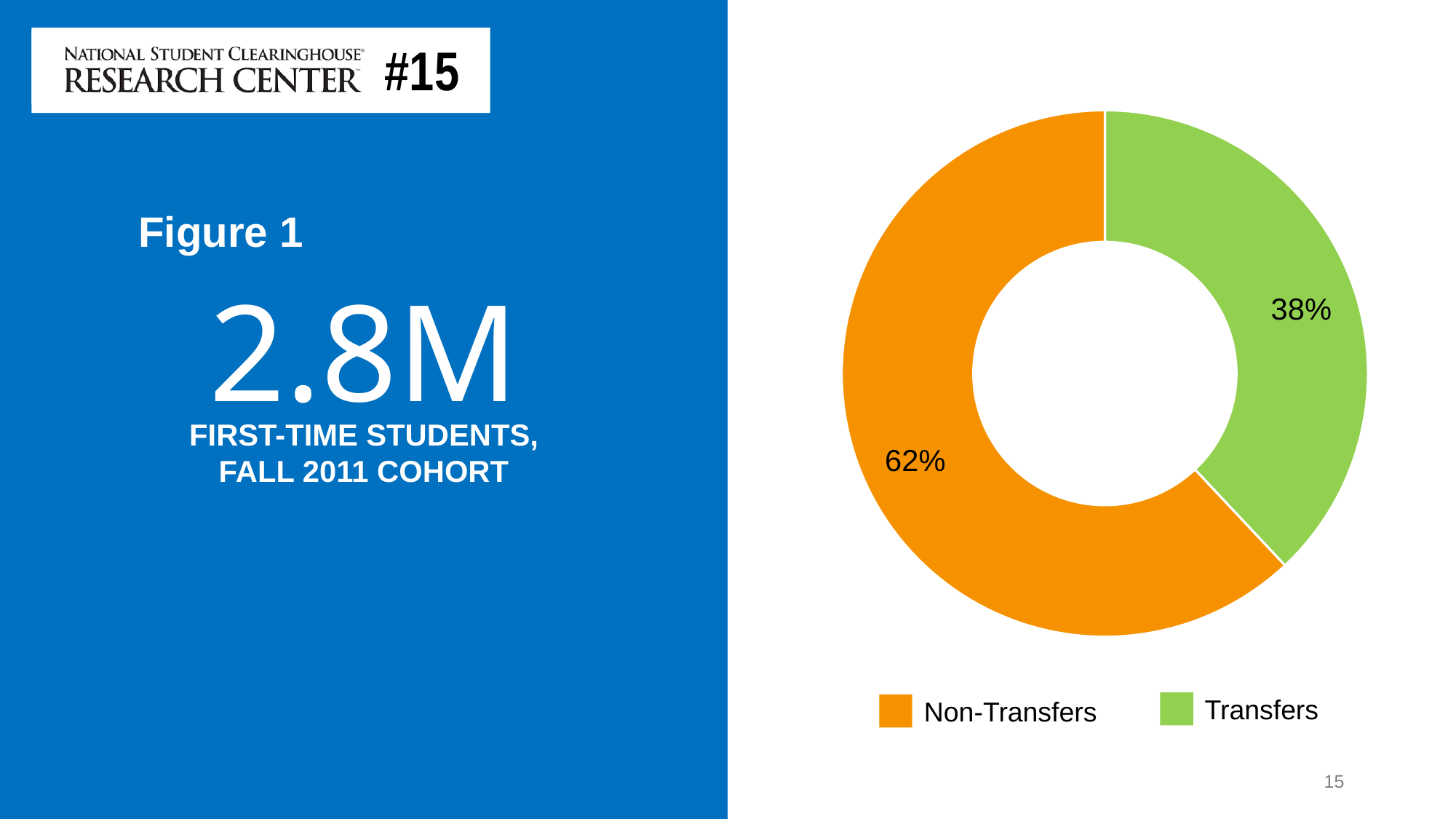
What kind of chart is shown on the slide? Donut (pie) chart Which category has the smallest share in the chart? Transfers Which is larger, the share for Non-Transfers or the share for Transfers? Non-Transfers What share of the donut chart is Transfers? 38% Which category has the largest share in the chart? Non-Transfers What colour represents Transfers in the chart? Green What is the total of the two shares shown in the chart? 100% How many entries does the legend list? 2 What is the difference in percentage points between Non-Transfers and Transfers? 24 percentage points How many categories does the chart show? 2 What share of the donut chart is Non-Transfers? 62% What colour represents Non-Transfers in the chart? Orange